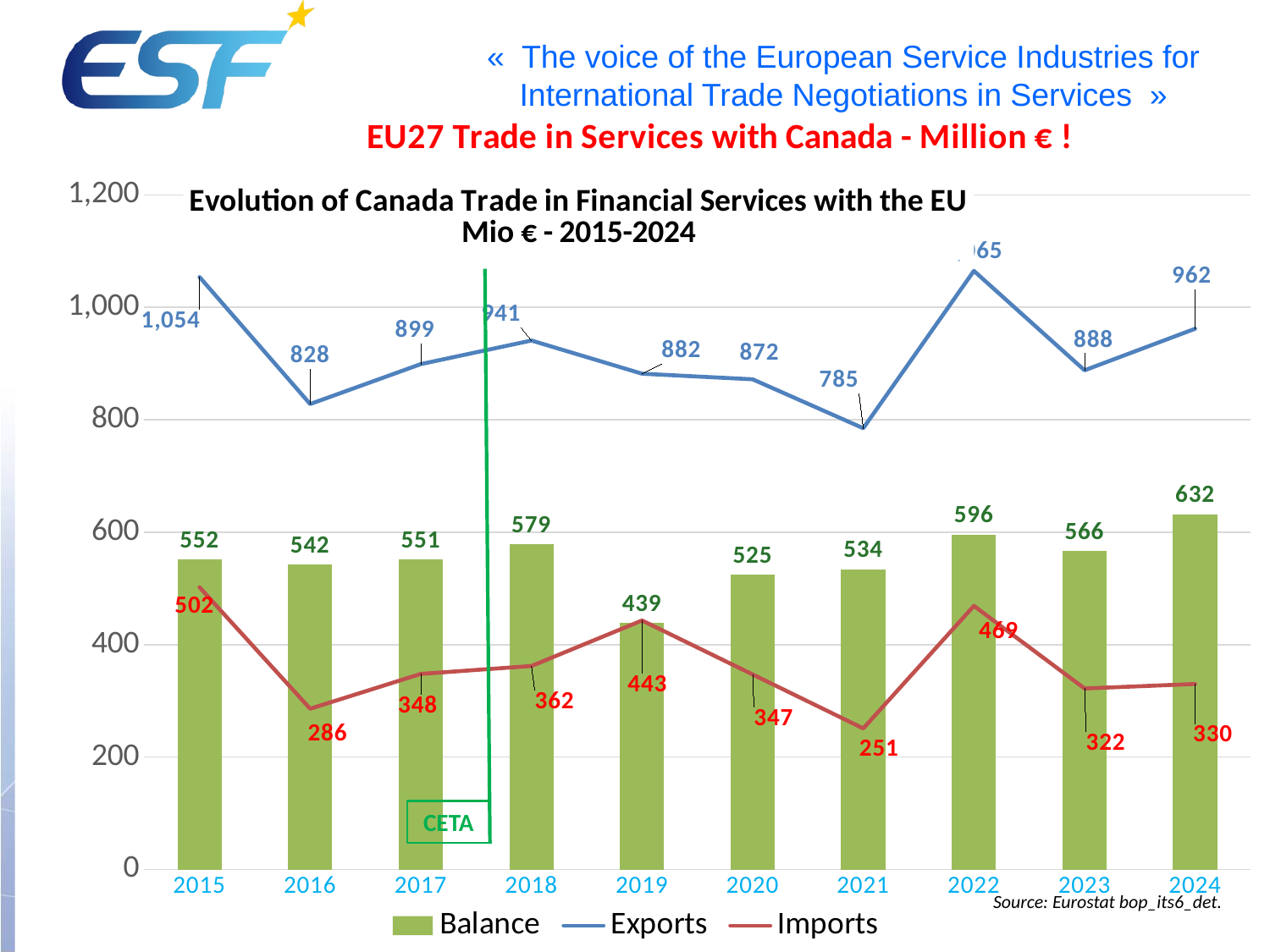
What is the difference between Exports in 2015 and Exports in 2016? 226 Do Exports rise or fall from 2018 to 2021? fall In which year are Imports the highest? 2015 What is the Imports value for 2021? 251 In which year are Exports the lowest? 2021 In which year is the Balance the lowest? 2019 What is the Balance value for 2024? 632 How many years are shown on the x axis? 10 What label is shown in the green box marking the vertical line between 2017 and 2018? CETA What is the Exports value for 2015? 1,054 Which is larger, the Balance in 2018 or the Balance in 2020? Balance in 2018 How many series does the legend list? 3